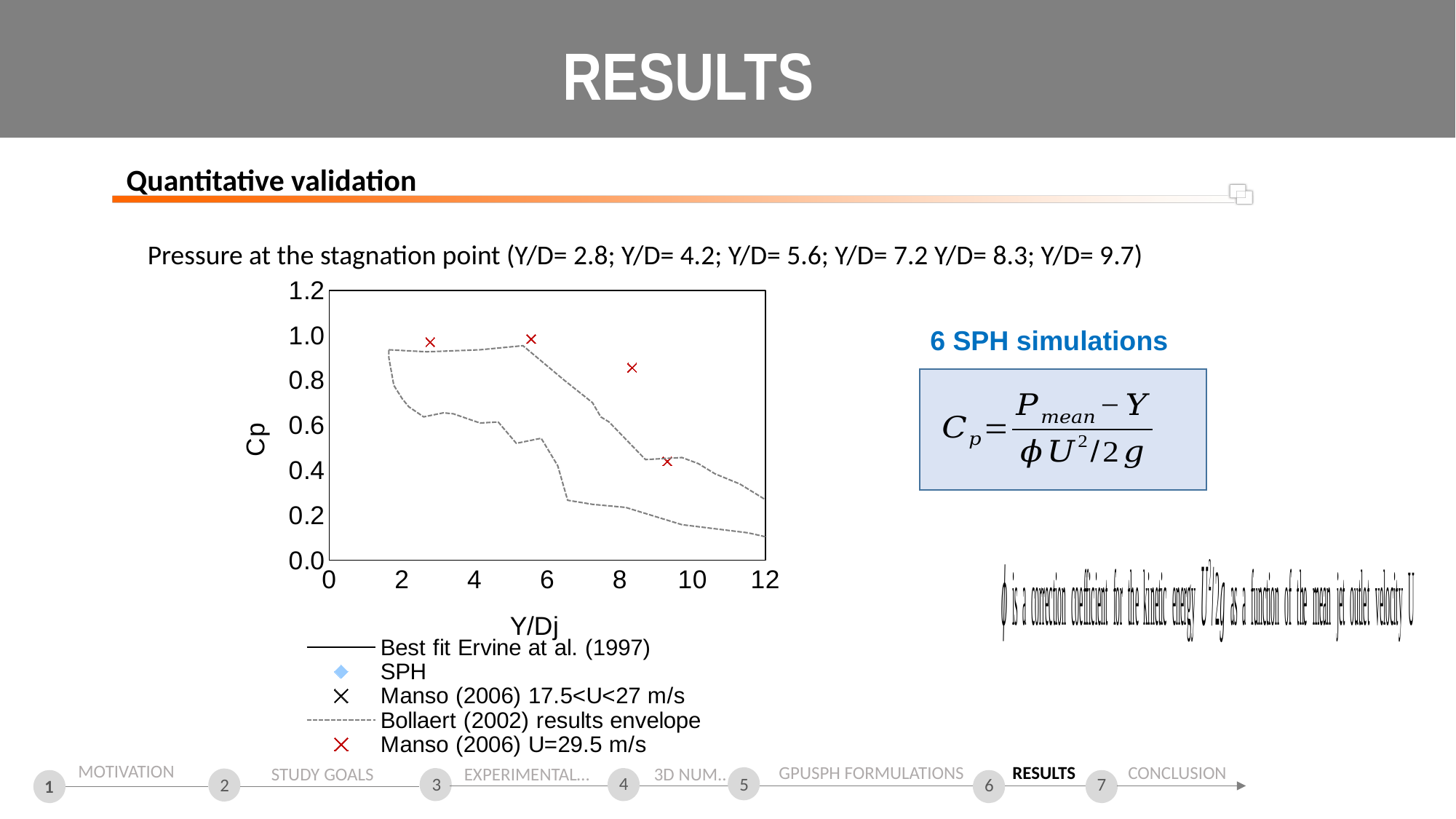
Is the Cp value of the red X marker near Y/Dj = 5.6 greater or less than 0.8? greater Is the Cp value of the red X marker near Y/Dj = 9.3 greater or less than 0.6? less How many series does the chart legend list? 5 Is the Cp value of the red X marker near Y/Dj = 8.3 greater or less than 0.6? greater How many red X markers (Manso (2006) U=29.5 m/s) are plotted on the chart? 4 Does the Bollaert (2002) results envelope rise or fall as Y/Dj increases? fall Which legend entry is represented by the dashed line? Bollaert (2002) results envelope What kind of chart is shown on the slide? scatter chart Which has the larger Cp value: the red X marker near Y/Dj = 2.8 or the red X marker near Y/Dj = 9.3? the marker near Y/Dj = 2.8 What is the label of the vertical axis of the chart? Cp Which red X marker has the lowest Cp value: the one near Y/Dj = 2.8 or the one near Y/Dj = 9.3? the one near Y/Dj = 9.3